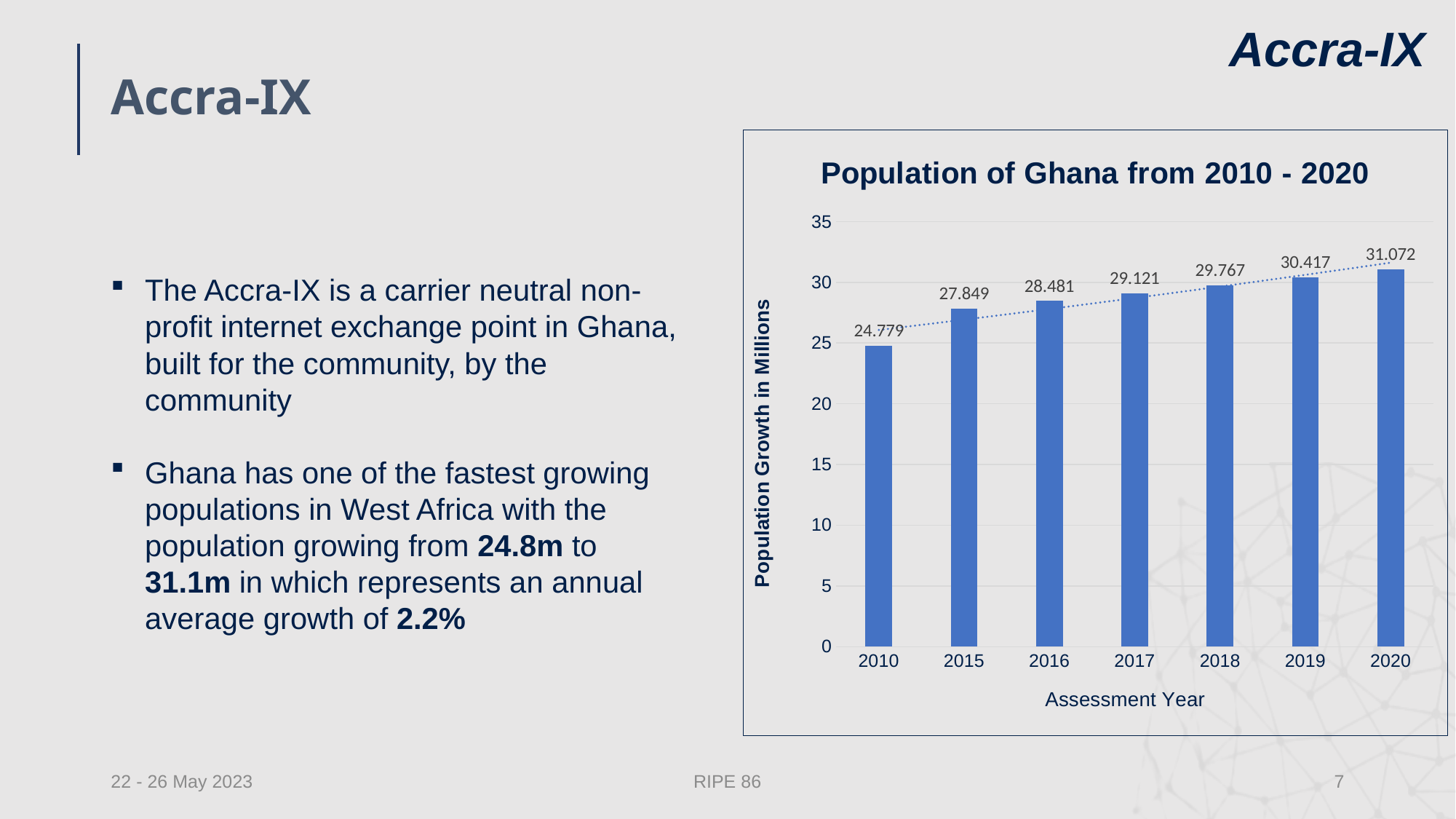
What is the population value shown for 2020? 31.072 What is the population value shown for 2017? 29.121 Which year has a larger population value, 2015 or 2018? 2018 What is the difference between the population values for 2020 and 2010? 6.293 Which year has the lowest population value? 2010 What is the population value shown for 2010? 24.779 What kind of chart is shown on the slide? Bar chart Is the value for 2019 greater or less than 30? greater How many years are shown on the x axis? 7 Which year has the highest population value? 2020 What is the title of the chart? Population of Ghana from 2010 - 2020 Do the population values rise or fall from 2010 to 2020? Rise